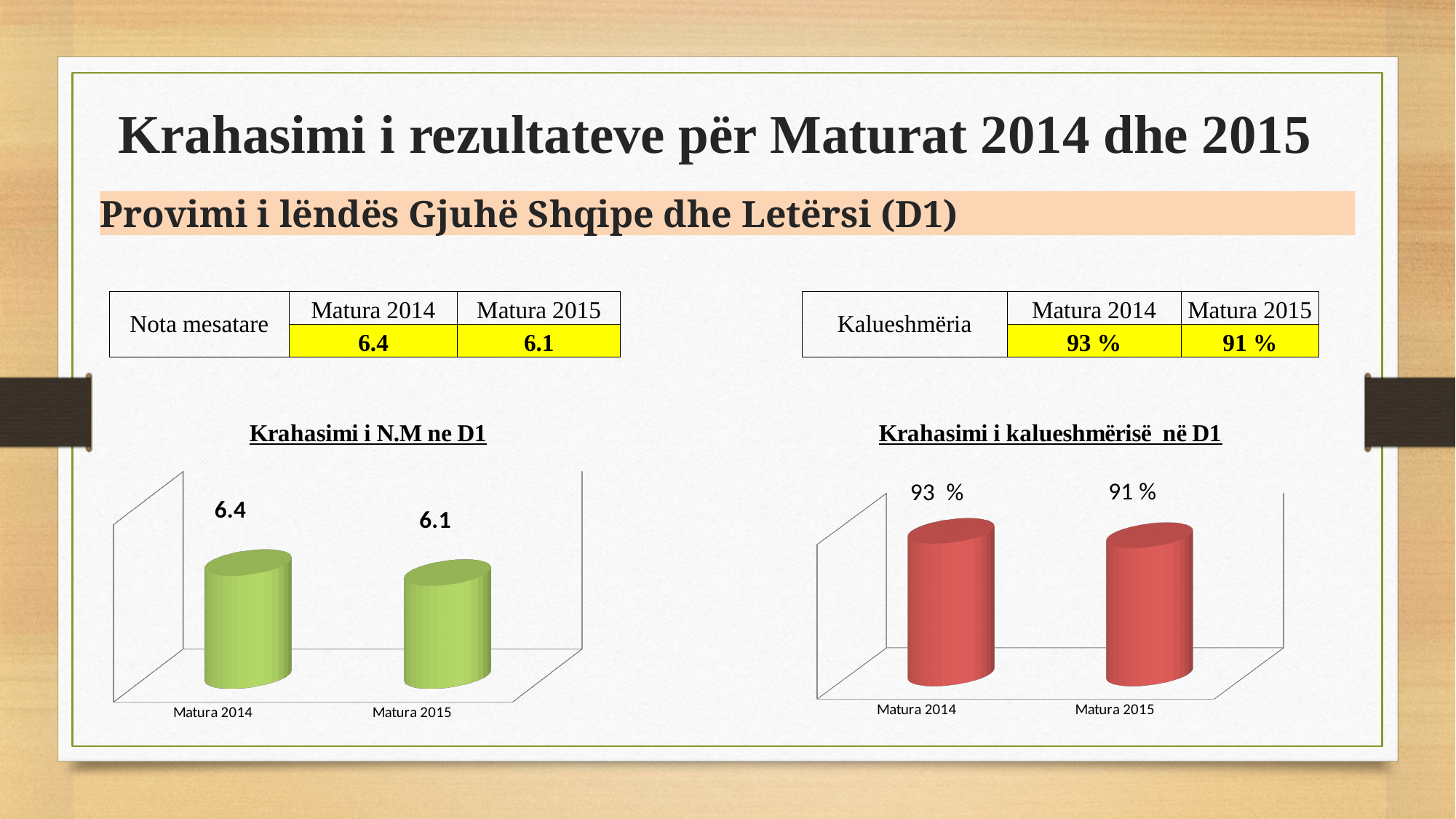
What kind of chart is the chart titled "Krahasimi i kalueshmërisë në D1"? Bar chart In the chart titled "Krahasimi i kalueshmërisë në D1", what is the value for Matura 2015? 91 % In the chart titled "Krahasimi i N.M ne D1", do the values rise or fall from Matura 2014 to Matura 2015? Fall In the chart titled "Krahasimi i N.M ne D1", what is the difference between the values for Matura 2014 and Matura 2015? 0.3 In the chart titled "Krahasimi i N.M ne D1", what is the value for Matura 2015? 6.1 In the chart titled "Krahasimi i kalueshmërisë në D1", which category has the lowest value? Matura 2015 In the chart titled "Krahasimi i kalueshmërisë në D1", which is larger, the value for Matura 2014 or Matura 2015? Matura 2014 In the chart titled "Krahasimi i kalueshmërisë në D1", what is the value for Matura 2014? 93 % In the chart titled "Krahasimi i N.M ne D1", what is the value for Matura 2014? 6.4 In the chart titled "Krahasimi i N.M ne D1", which category has the highest value? Matura 2014 In the chart titled "Krahasimi i kalueshmërisë në D1", what is the difference between the values for Matura 2014 and Matura 2015? 2 % How many categories are shown in the chart titled "Krahasimi i N.M ne D1"? 2